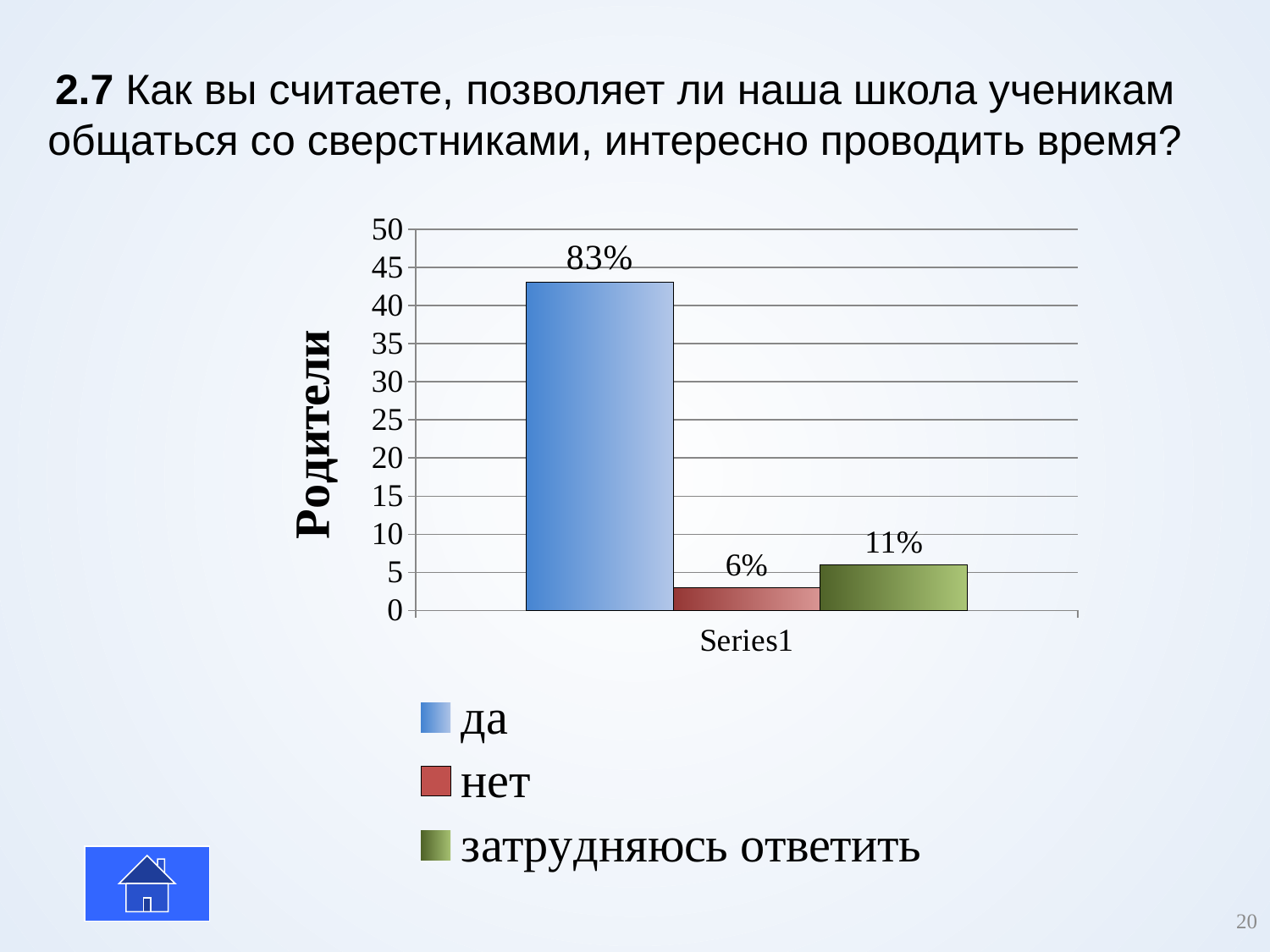
What kind of chart is shown on the slide? bar chart What is the data label on the bar for "да"? 83% How many bars are plotted in the chart? 3 By how many percentage points does the label for "да" exceed the label for "затрудняюсь ответить"? 72 What is the title of the vertical axis? Родители Which is larger, the bar for "нет" or the bar for "затрудняюсь ответить"? затрудняюсь ответить What is the data label on the bar for "нет"? 6% Which answer option has the lowest bar? нет On the vertical axis, is the bar for "да" greater or less than 40? greater What is the data label on the bar for "затрудняюсь ответить"? 11% On the vertical axis, is the bar for "нет" greater or less than 5? less Which answer option has the highest bar? да